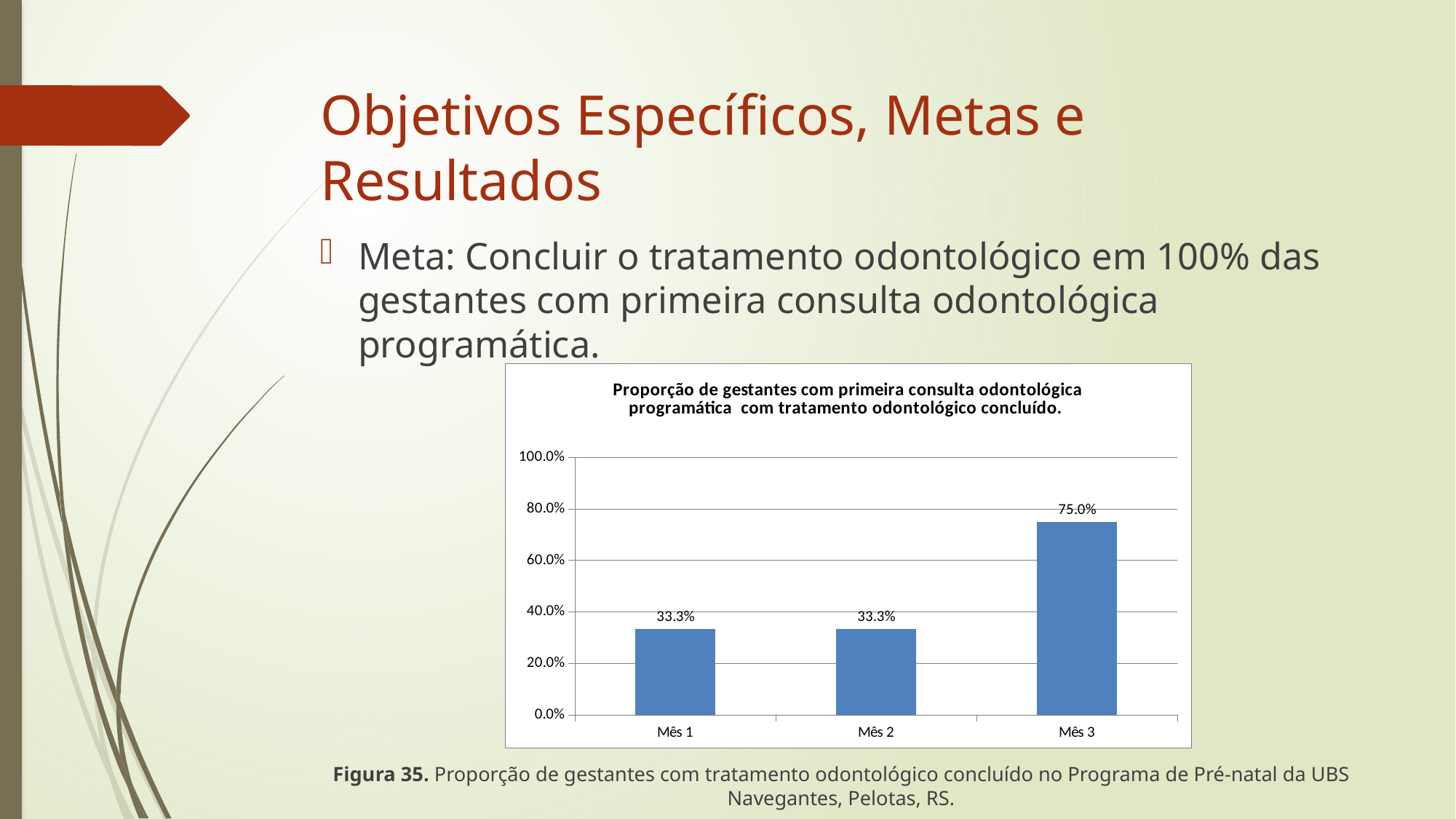
What kind of chart is shown on the slide? bar chart Which month has the highest value? Mês 3 What is the highest value shown on the y axis? 100.0% What is the difference between the values for Mês 3 and Mês 2? 41.7% Do Mês 1 and Mês 2 have the same value? Yes What is the value for Mês 1? 33.3% Do the values rise or fall from Mês 2 to Mês 3? rise Which is larger, the value for Mês 1 or the value for Mês 3? Mês 3 What is the value for Mês 3? 75.0% Is the value for Mês 3 greater or less than 60.0%? greater How many months are shown on the x axis? 3 Is the value for Mês 2 greater or less than 40.0%? less